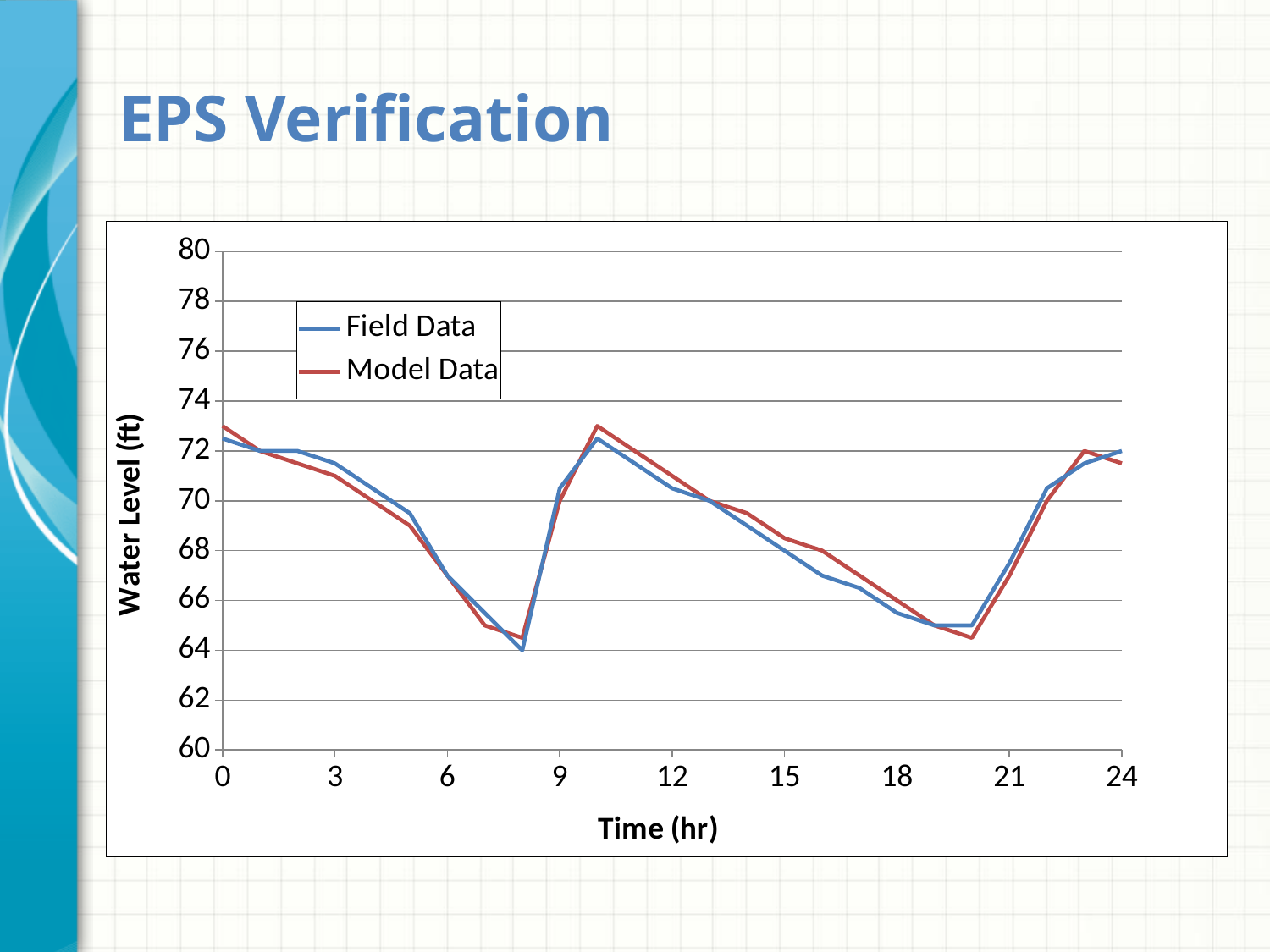
What kind of chart is shown on the slide? line chart Between hour 3 and hour 8, does the Field Data line rise or fall? fall How many series does the legend list? 2 Between hour 20 and hour 23, does the Model Data line rise or fall? rise What is the title of the vertical axis? Water Level (ft) At hour 16, which series shows the higher water level, Field Data or Model Data? Model Data What are the two series named in the legend? Field Data and Model Data Is the Field Data value at hour 0 greater or less than 70? greater Is the Model Data value at hour 10 greater or less than 72? greater Is the Field Data value at hour 8 greater or less than 66? less What is the Field Data water level at hour 8? 64